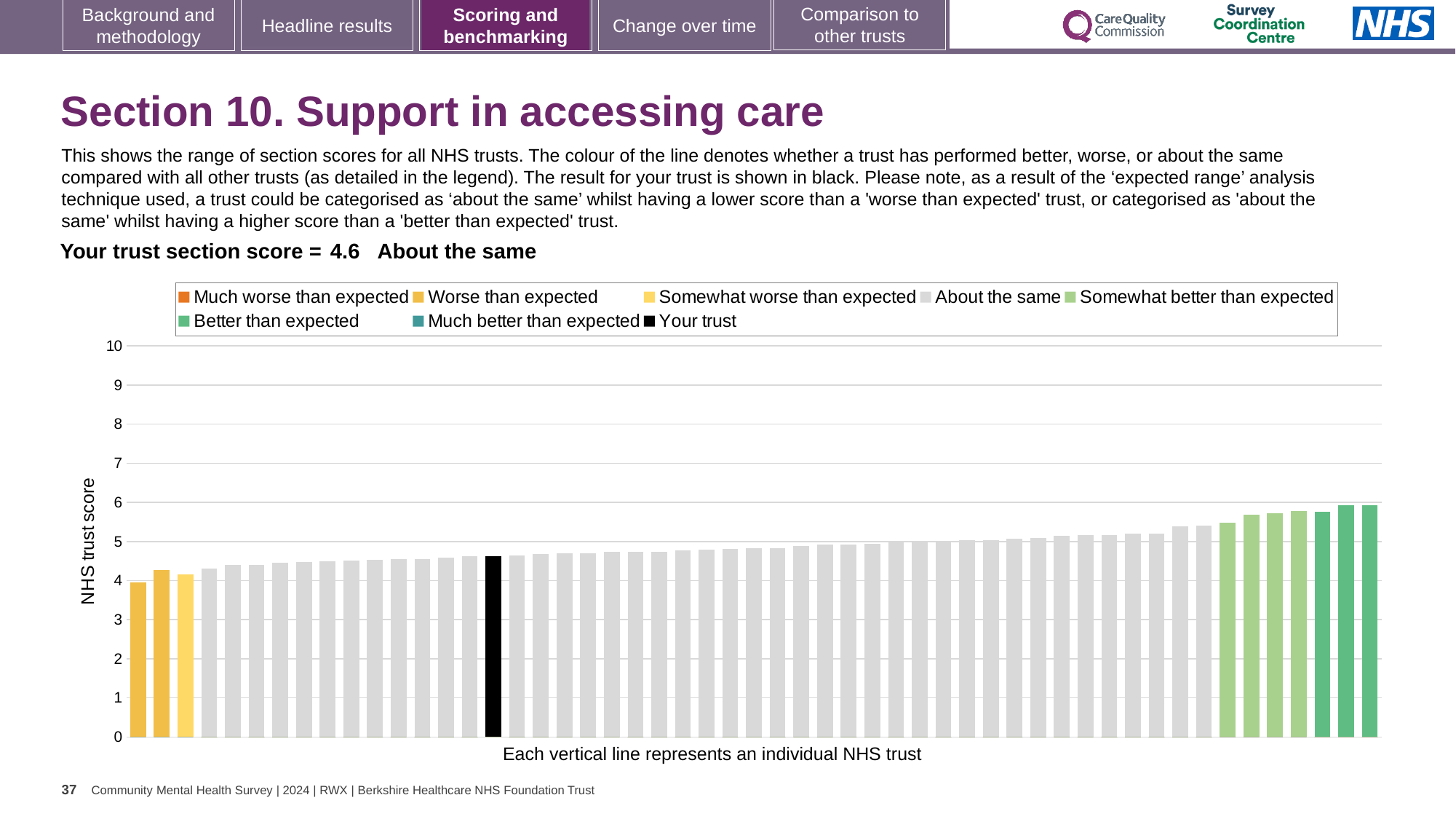
Is the value for your trust greater or less than 4? greater What kind of chart is shown on the slide? bar chart Which legend category is your trust placed in? About the same What colour is the bar representing your trust? black How many entries does the chart legend list? 8 Do the bar values rise or fall from left to right along the x axis? rise Is the shortest bar in the chart greater or less than 5? less Is the tallest bar in the chart greater or less than 5? greater What is the section score for your trust? 4.6 What is the label on the vertical axis of the chart? NHS trust score Which legend category do the tallest bars on the right of the chart belong to? Better than expected